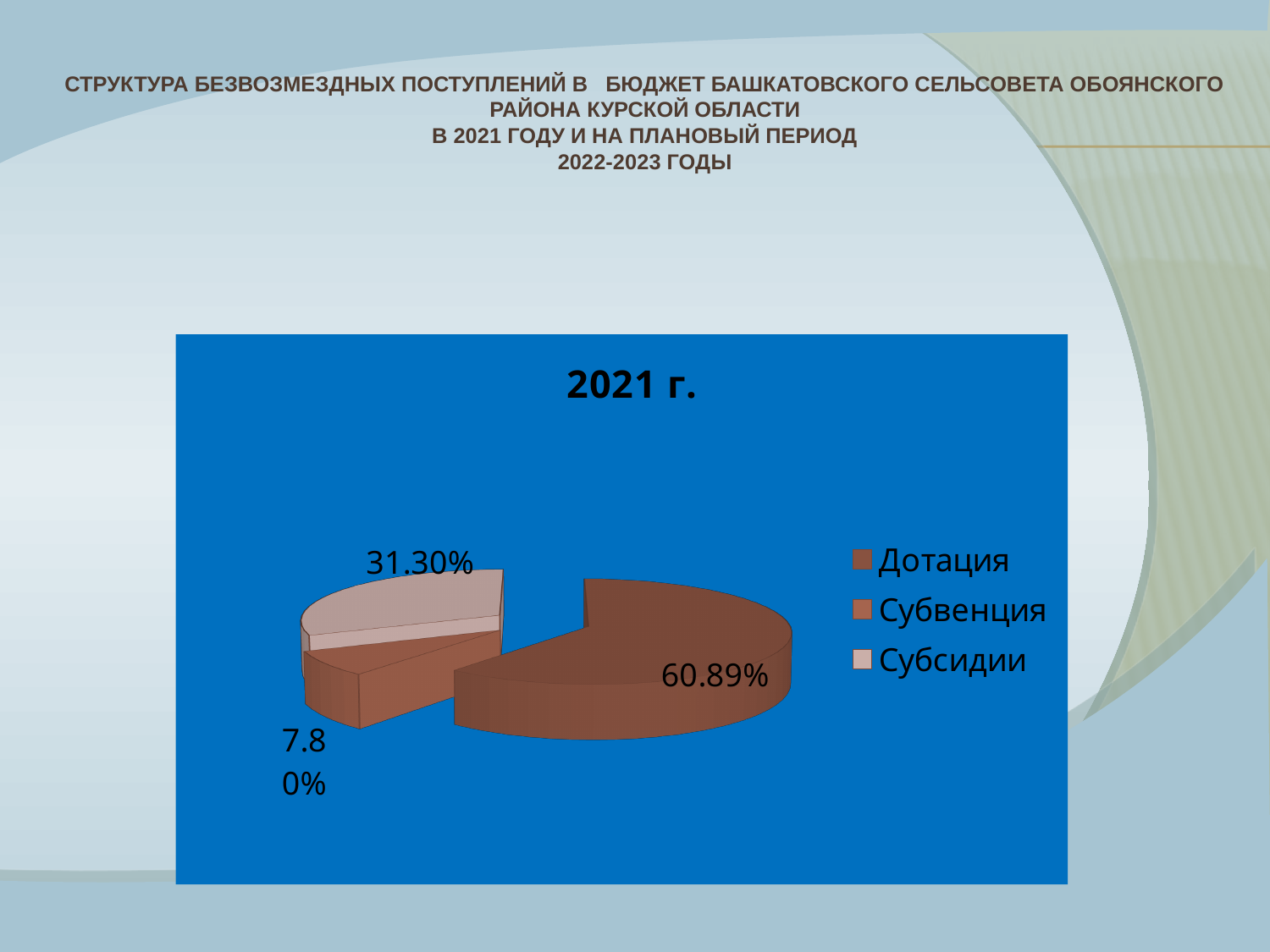
How many slices does the pie chart have? 3 What kind of chart is shown on the slide? pie chart What share of the pie does Субвенция have? 7.80% What is the difference between the share for Дотация and the share for Субсидии? 29.59% How many entries does the legend list? 3 Which category has the smallest slice of the pie? Субвенция What share of the pie does Дотация have? 60.89% What is the title of the chart? 2021 г. Which legend entry is listed first? Дотация Which is larger, the share for Субсидии or the share for Субвенция? Субсидии What share of the pie does Субсидии have? 31.30% Which category has the largest slice of the pie? Дотация